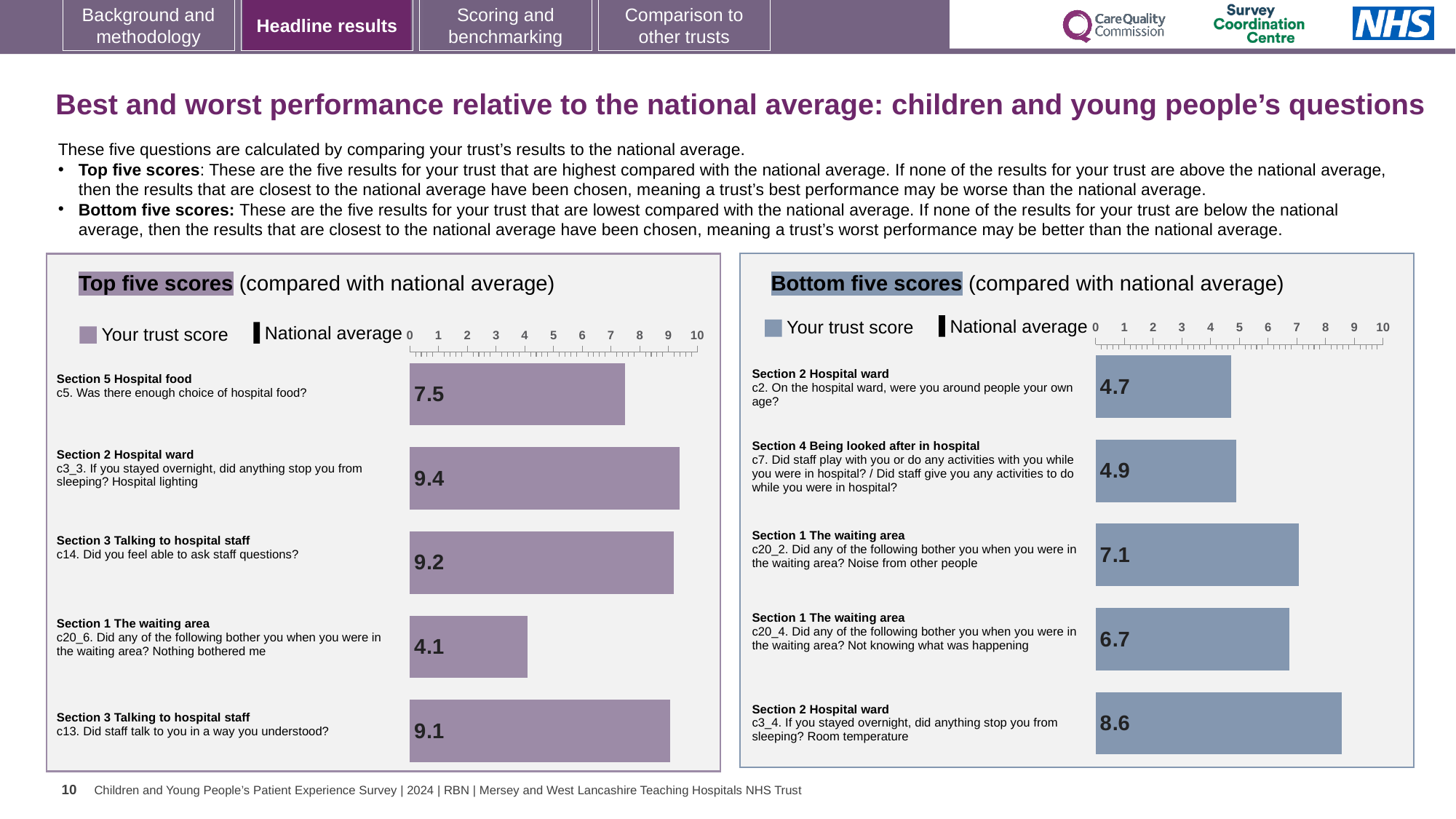
How many questions are plotted in the 'Bottom five scores' chart? 5 In the 'Bottom five scores' chart, which is larger: the trust score for c7 or for c20_2? c20_2 In the 'Top five scores' chart, what is the difference between the trust scores for c14 and c20_6? 5.1 In the 'Top five scores' chart, which question has the lowest trust score? c20_6. Did any of the following bother you when you were in the waiting area? Nothing bothered me In the 'Top five scores' chart, what is the trust score for c13 'Did staff talk to you in a way you understood?' 9.1 In the 'Bottom five scores' chart, which question has the highest trust score? c3_4. If you stayed overnight, did anything stop you from sleeping? Room temperature What type of chart is the 'Top five scores' chart? Bar chart In the 'Top five scores' chart, what is the trust score for c5 'Was there enough choice of hospital food?' 7.5 In the 'Bottom five scores' chart, what is the trust score for c2 'On the hospital ward, were you around people your own age?' 4.7 In the 'Bottom five scores' chart, what is the difference between the trust scores for c3_4 and c2? 3.9 In the 'Bottom five scores' chart, what is the trust score for c20_4 'Not knowing what was happening'? 6.7 In the 'Top five scores' chart, which question has the highest trust score? c3_3. If you stayed overnight, did anything stop you from sleeping? Hospital lighting